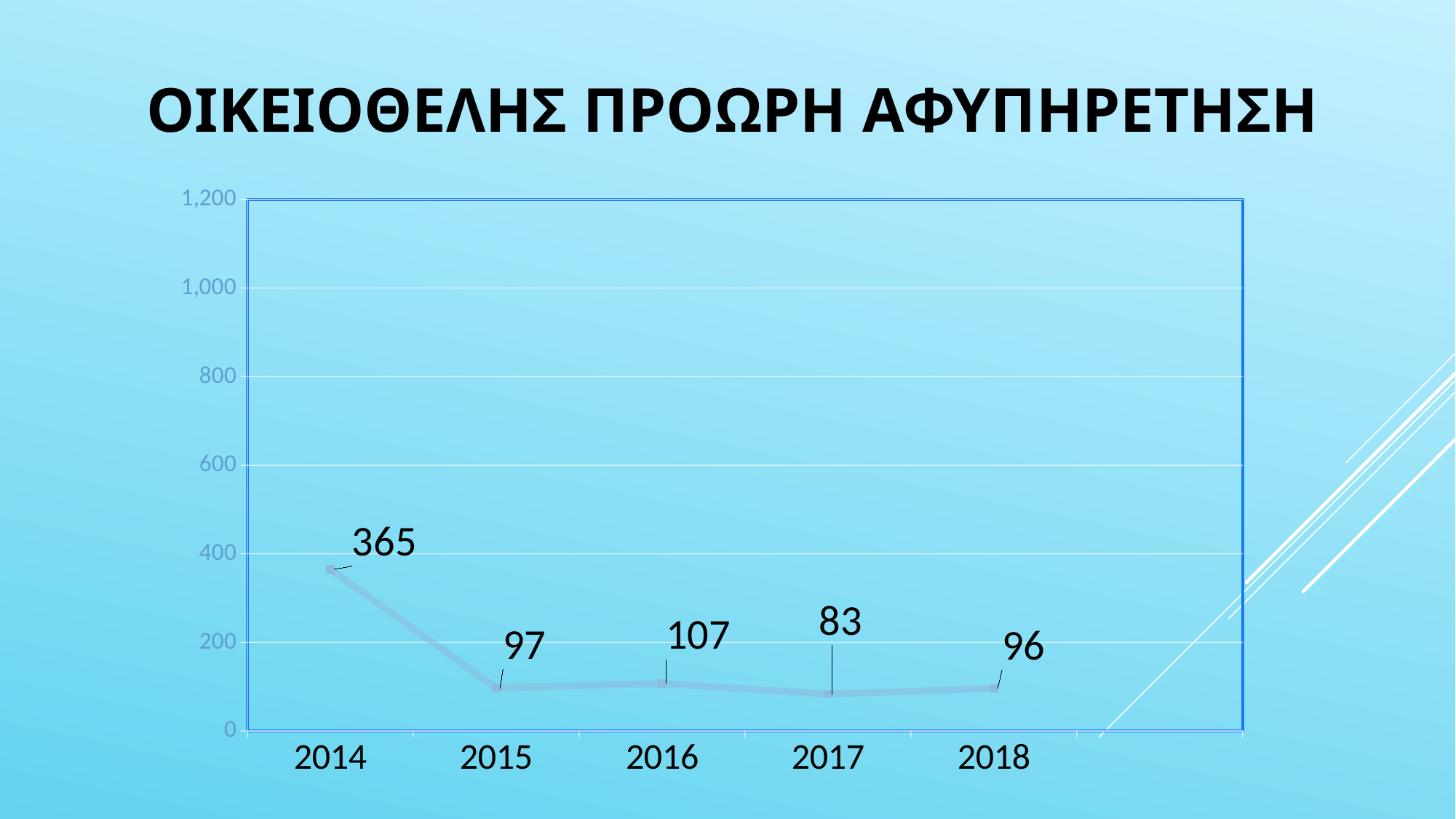
What is the difference between the values for 2014 and 2015? 268 Is the value for 2014 greater or less than 200? greater What is the difference between the values for 2016 and 2017? 24 What is the value for 2016? 107 How many years are plotted on the chart? 5 What is the value for 2018? 96 Which year has the lowest value? 2017 What is the value for 2014? 365 What kind of chart is shown on the slide? line chart Which is larger, the value for 2015 or the value for 2016? 2016 Which year has the highest value? 2014 Does the value rise or fall from 2014 to 2015? fall